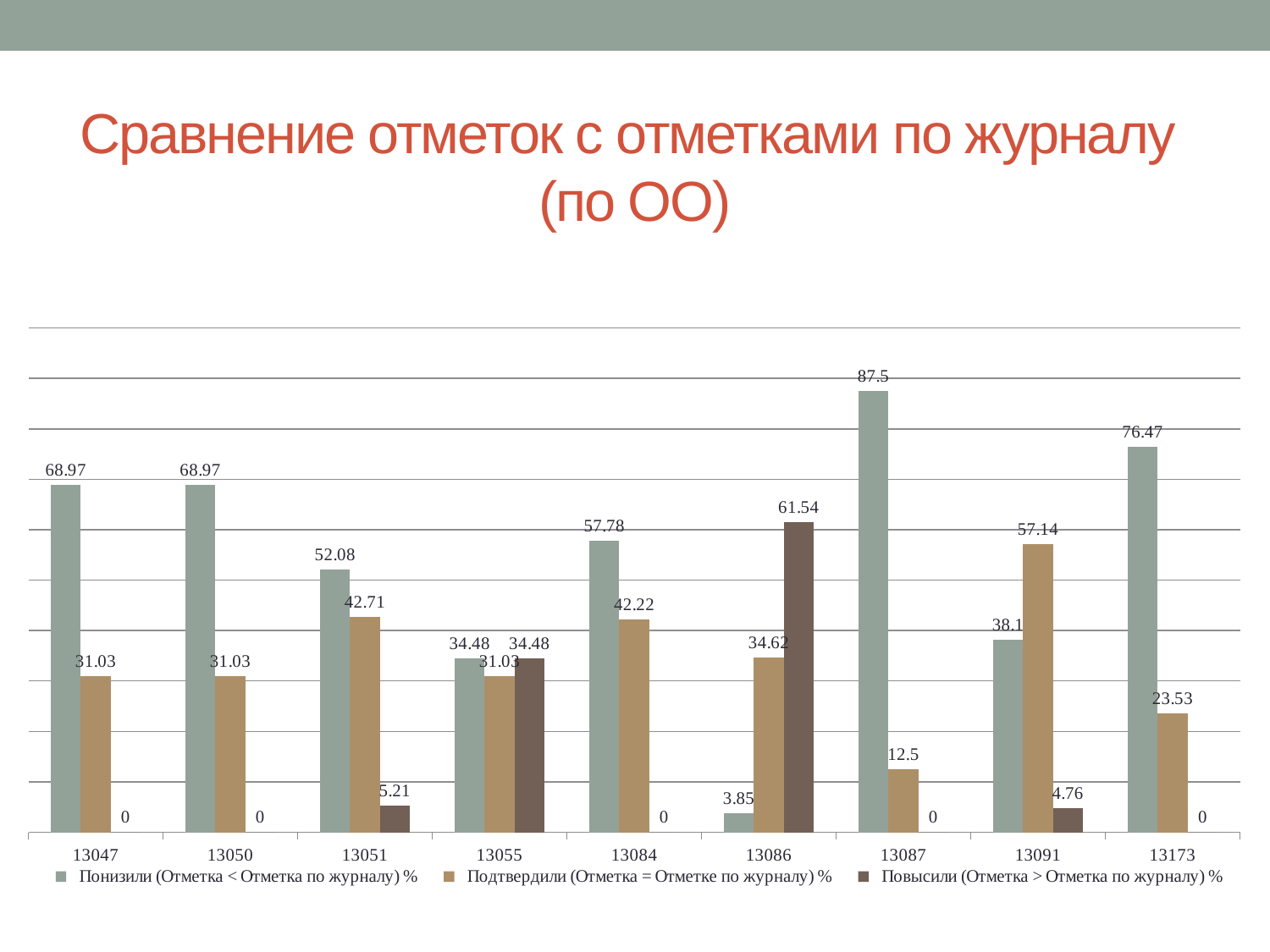
How many categories are shown along the x axis? 9 What is the value of Повысили (Отметка > Отметка по журналу) % for category 13086? 61.54 What is the value of Повысили (Отметка > Отметка по журналу) % for category 13051? 5.21 Which category has the highest value for Понизили (Отметка < Отметка по журналу) %? 13087 What is the value of Понизили (Отметка < Отметка по журналу) % for category 13087? 87.5 What is the title of the chart slide? Сравнение отметок с отметками по журналу (по ОО) What type of chart is shown on the slide? bar chart Which category has the lowest value for Понизили (Отметка < Отметка по журналу) %? 13086 What is the difference between the Понизили and Подтвердили values for category 13173? 52.94 For category 13091, which is larger: Понизили or Подтвердили? Подтвердили What is the value of Подтвердили (Отметка = Отметке по журналу) % for category 13091? 57.14 How many series does the legend list? 3